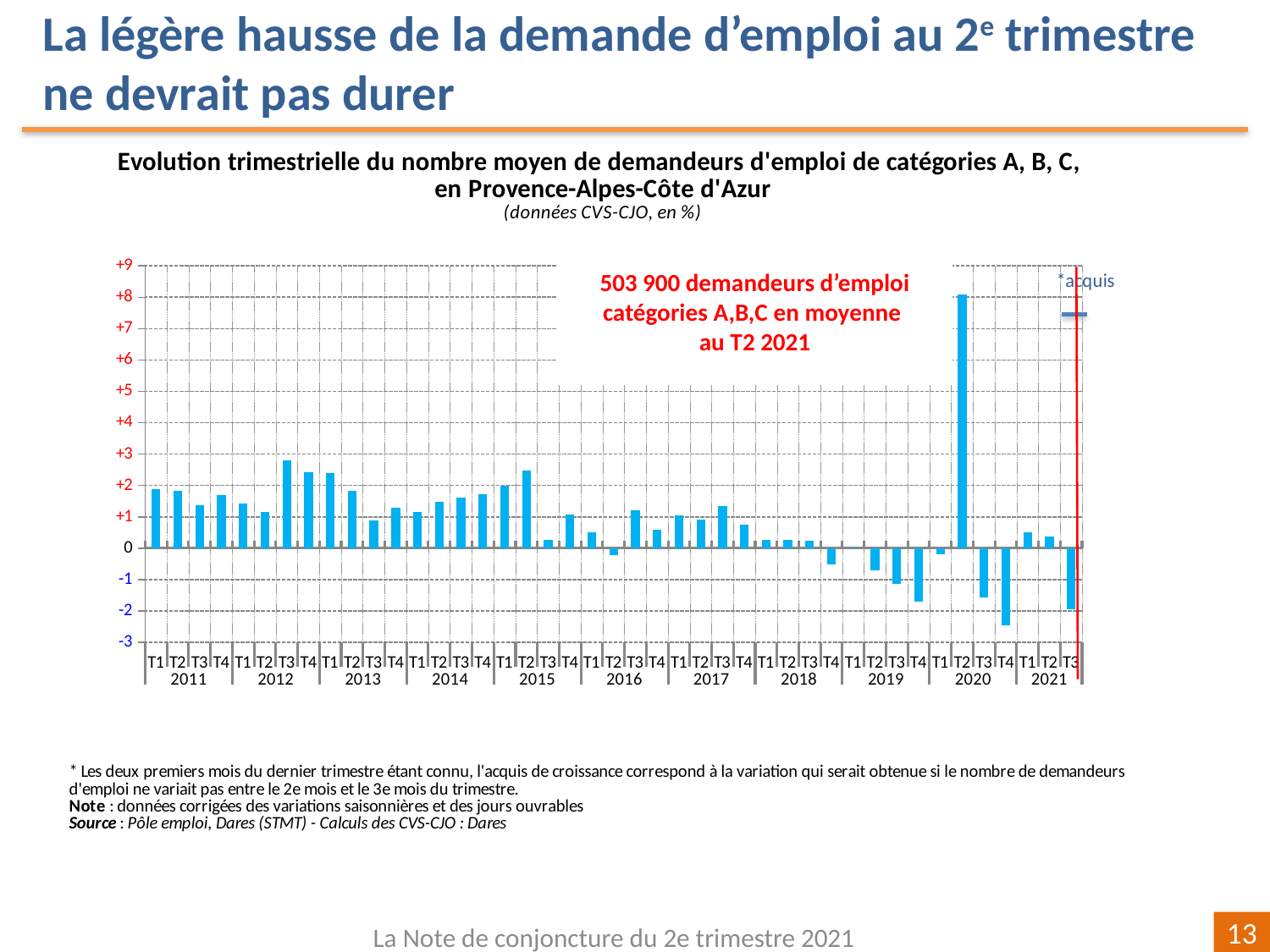
Is the value for T3 2021 greater or less than -1? less Is the value for T4 2020 greater or less than -2? less According to the red annotation on the chart, how many demandeurs d'emploi of catégories A, B, C were there on average in T2 2021? 503 900 Do the values rise or fall from T1 2019 to T4 2019? fall Which quarter has the lowest value in the chart? T4 2020 Which is larger, the value for T3 2012 or the value for T1 2015? T3 2012 Is the value for T2 2020 greater or less than +7? greater How many quarterly bars are plotted in the chart? 43 What kind of chart is shown on the slide? bar chart Which quarter has the highest value in the chart? T2 2020 Which is lower, the value for T4 2020 or the value for T3 2021? T4 2020